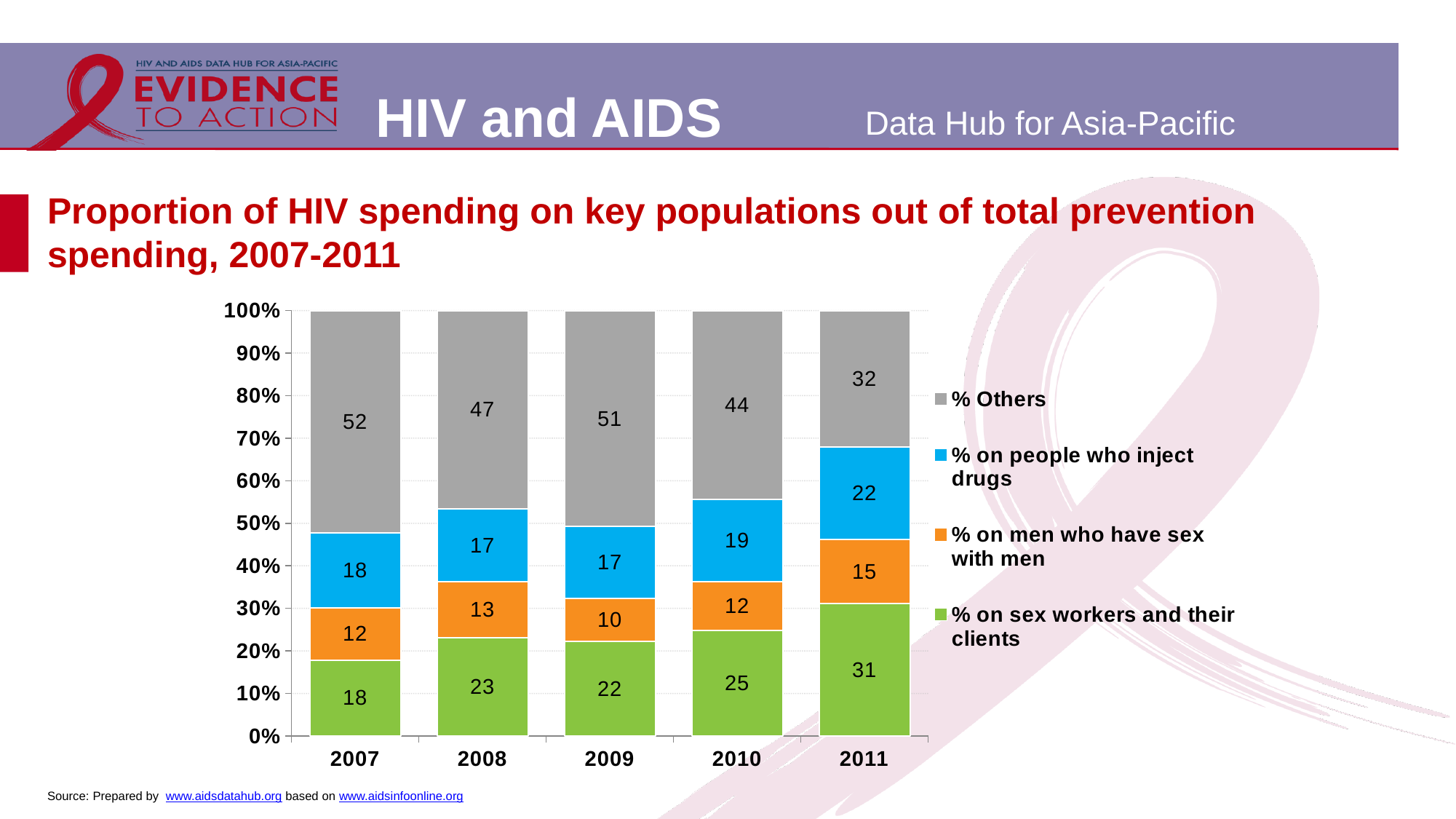
What kind of chart is shown on the slide? Stacked bar chart What is the value for % on people who inject drugs in 2010? 19 What is the difference between the % Others values for 2007 and 2011? 20 Which is larger: % on people who inject drugs in 2008 or in 2011? 2011 What is the value for % on sex workers and their clients in 2011? 31 What is the value for % Others in 2007? 52 How many years are shown on the x axis? 5 In which year is the % Others segment the lowest? 2011 What is the value for % on men who have sex with men in 2009? 10 How many series does the legend list? 4 Does the % on sex workers and their clients value rise or fall from 2009 to 2011? Rise In which year is the % on sex workers and their clients segment the highest? 2011